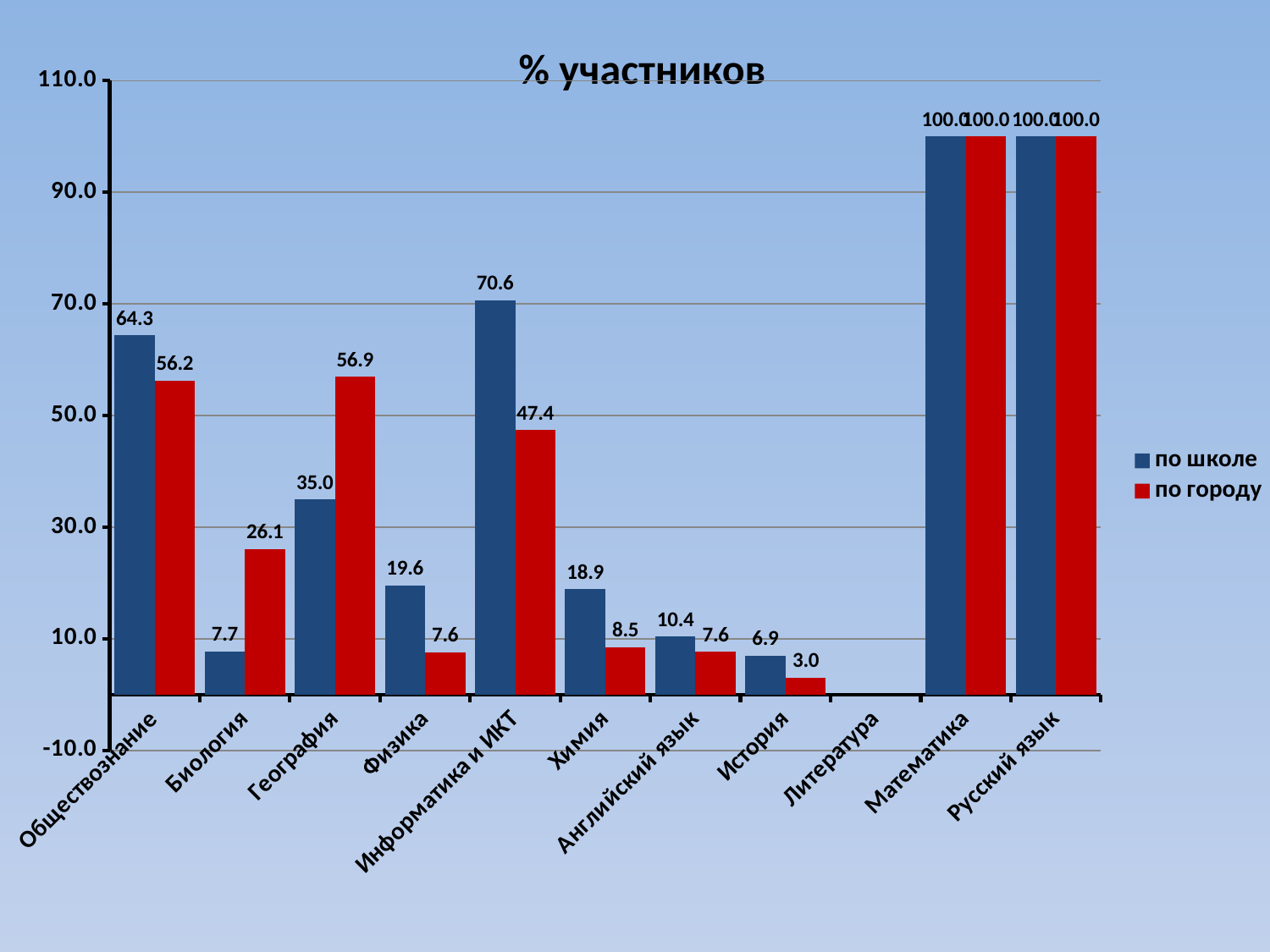
What is the value for Обществознание in the по школе series? 64.3 What is the value for Информатика и ИКТ in the по городу series? 47.4 Which category has the lowest value in the по городу series among those with a labelled bar? История What is the value for Биология in the по городу series? 26.1 For Биология, which series has the larger value, по школе or по городу? по городу What is the difference between the по школе and по городу values for Физика? 12.0 What is the difference between the по городу and по школе values for География? 21.9 How many categories are shown on the x axis? 11 What is the value for История in the по школе series? 6.9 What is the title of the chart? % участников How many series does the legend list? 2 For Химия, which series has the larger value, по школе or по городу? по школе